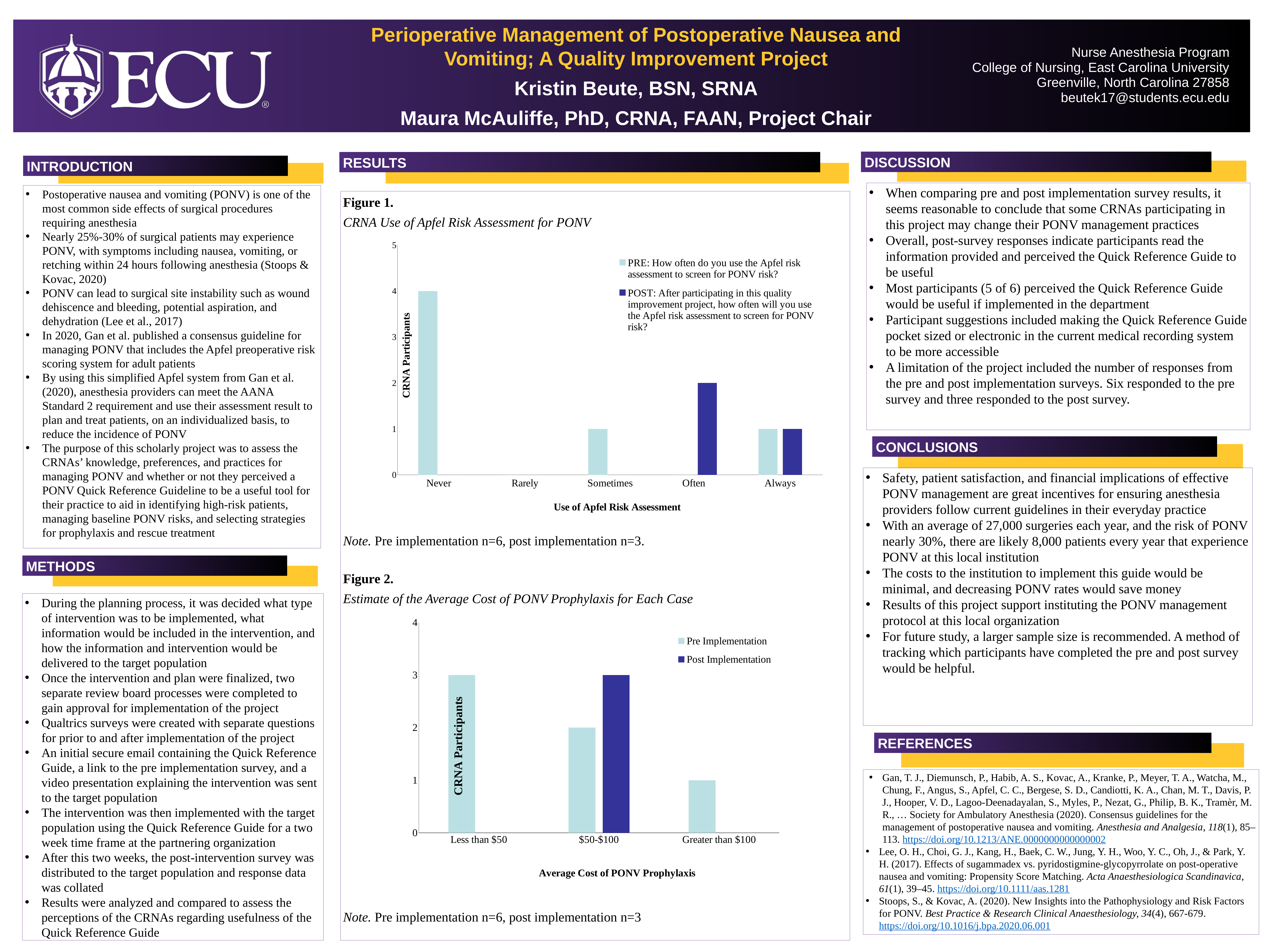
In Figure 1 (CRNA Use of Apfel Risk Assessment for PONV), how many series does the legend list? 2 In Figure 1 (CRNA Use of Apfel Risk Assessment for PONV), what is the difference between the PRE value for 'Never' and the PRE value for 'Sometimes'? 3 In Figure 1 (CRNA Use of Apfel Risk Assessment for PONV), how many categories are shown on the x axis? 5 In Figure 1 (CRNA Use of Apfel Risk Assessment for PONV), what is the PRE value for the 'Never' category? 4 What kind of chart is Figure 2 (Estimate of the Average Cost of PONV Prophylaxis for Each Case)? Bar chart In Figure 2 (Estimate of the Average Cost of PONV Prophylaxis for Each Case), which is larger for '$50-$100': the Pre Implementation value or the Post Implementation value? Post Implementation In Figure 2 (Estimate of the Average Cost of PONV Prophylaxis for Each Case), what is the Pre Implementation value for 'Greater than $100'? 1 In Figure 1 (CRNA Use of Apfel Risk Assessment for PONV), what is the POST value for the 'Often' category? 2 In Figure 1 (CRNA Use of Apfel Risk Assessment for PONV), which category has the highest PRE value? Never In Figure 2 (Estimate of the Average Cost of PONV Prophylaxis for Each Case), what is the label of the y axis? CRNA Participants In Figure 2 (Estimate of the Average Cost of PONV Prophylaxis for Each Case), what is the Post Implementation value for '$50-$100'? 3 In Figure 2 (Estimate of the Average Cost of PONV Prophylaxis for Each Case), do the Pre Implementation values rise or fall from 'Less than $50' to 'Greater than $100'? Fall